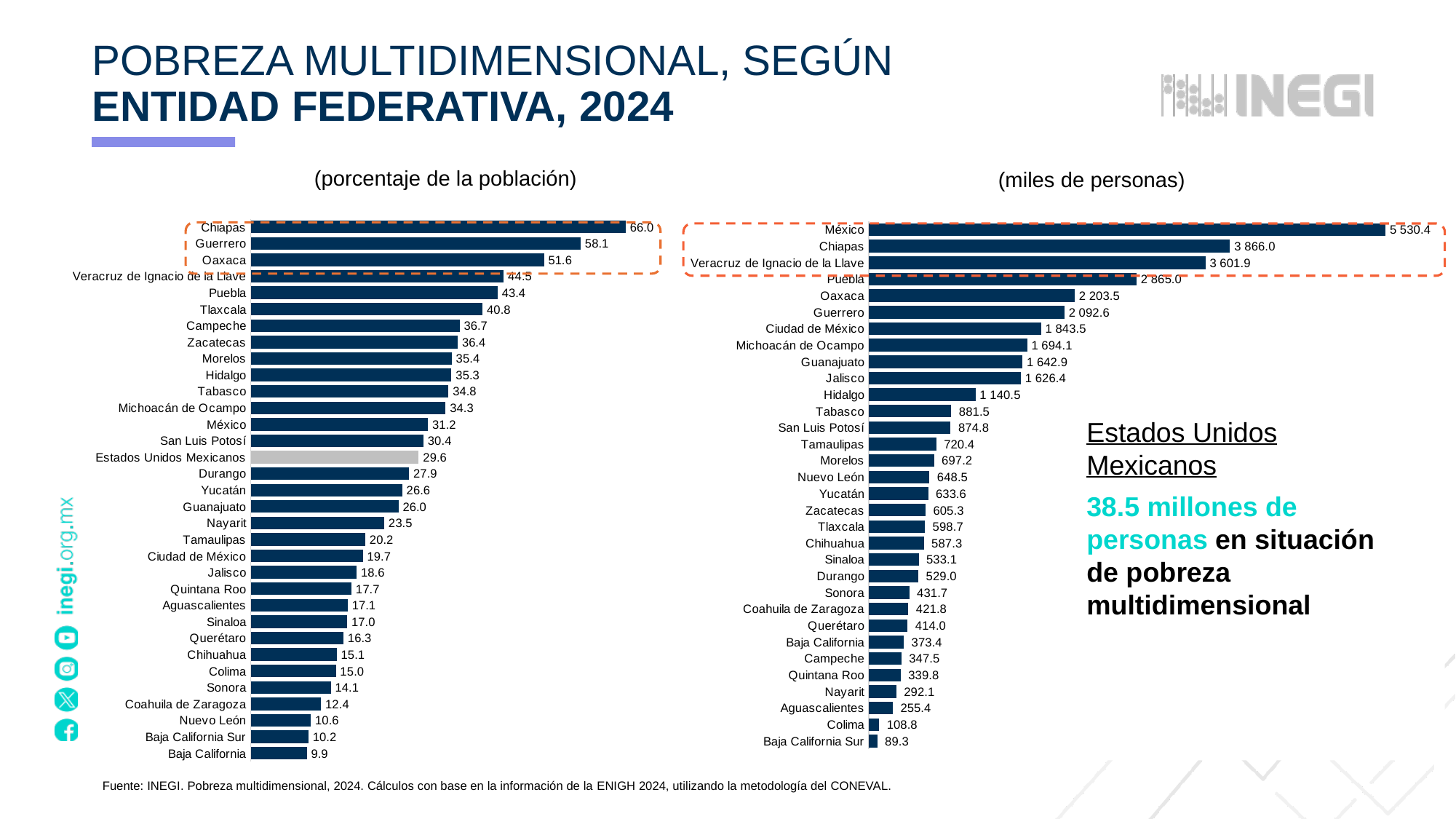
In the chart '(miles de personas)', what is the difference between the values for México and Chiapas? 1 664.4 In the chart '(miles de personas)', which is larger, the value for Oaxaca or the value for Guerrero? Oaxaca In the chart '(miles de personas)', which entity has the lowest value? Baja California Sur In the chart '(porcentaje de la población)', which is larger, the value for Puebla or the value for Tlaxcala? Puebla In the chart '(miles de personas)', which entity has the highest value? México In the chart '(porcentaje de la población)', what is the value for Estados Unidos Mexicanos? 29.6 In the chart '(miles de personas)', what is the value for Veracruz de Ignacio de la Llave? 3 601.9 In the chart '(porcentaje de la población)', which entity has the lowest value? Baja California In the chart '(porcentaje de la población)', what is the difference between the values for Chiapas and Guerrero? 7.9 In the chart '(porcentaje de la población)', what is the value for Chiapas? 66.0 What kind of chart is the chart '(porcentaje de la población)'? Bar chart How many categories are plotted in the chart '(miles de personas)'? 32